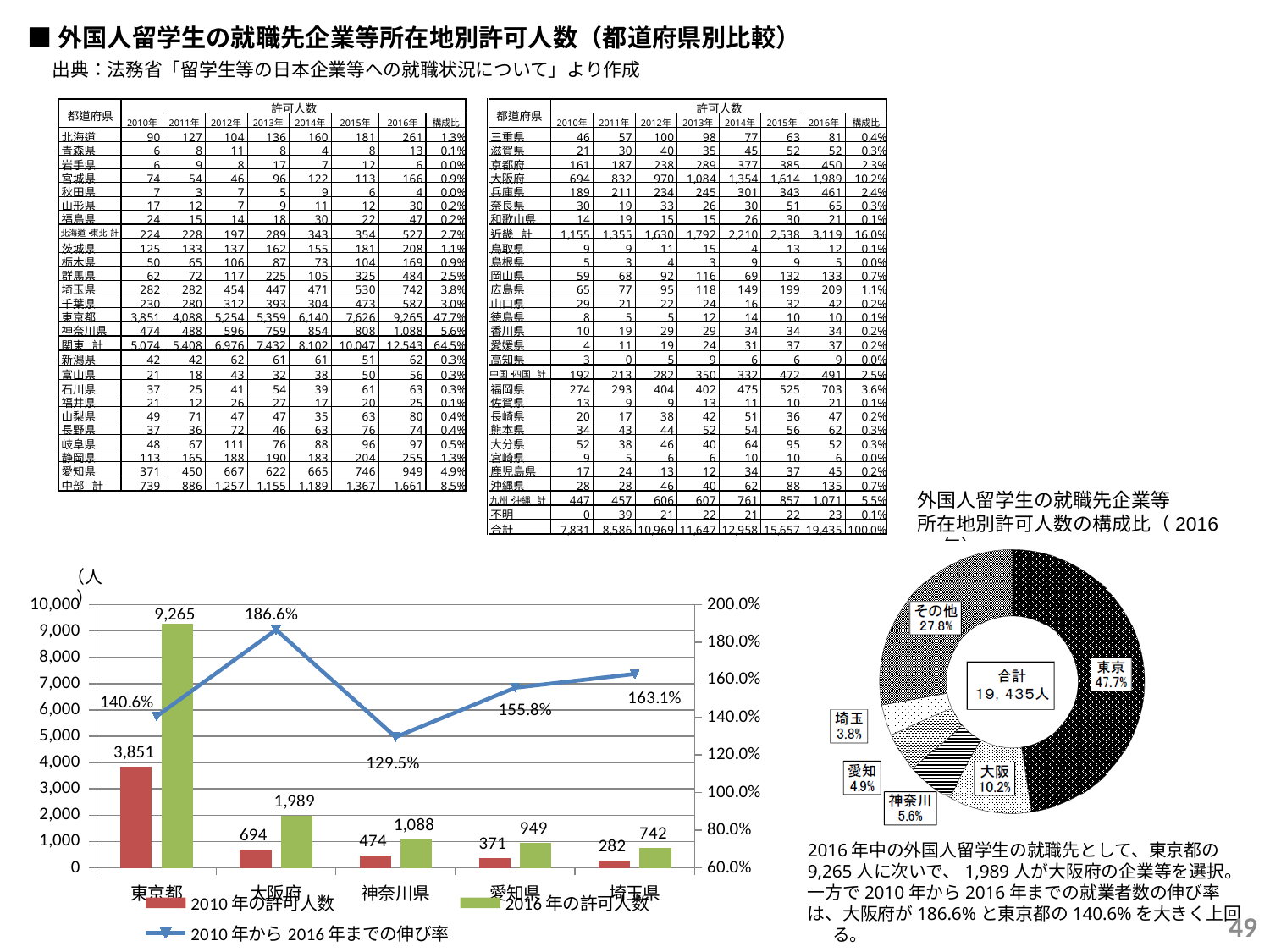
In the bar-and-line chart at the bottom left, what is the 2016 年の許可人数 value for 東京都? 9,265 In the bar-and-line chart at the bottom left, what is the 2010 年から 2016 年までの伸び率 for 神奈川県? 129.5% How many prefectures are shown on the x axis of the bar-and-line chart at the bottom left? 5 In the pie chart at the bottom right, what share does 東京 have? 47.7% In the pie chart at the bottom right, what is the 合計 shown in the centre? 19,435人 In the bar-and-line chart at the bottom left, which prefecture has the highest 2010 年から 2016 年までの伸び率? 大阪府 In the bar-and-line chart at the bottom left, which prefecture has the lowest 2016 年の許可人数? 埼玉県 What kind of chart is shown at the bottom right of the slide? Doughnut (ring) chart In the bar-and-line chart at the bottom left, what is the difference between the 2016 and 2010 許可人数 for 愛知県? 578 In the bar-and-line chart at the bottom left, which is larger: the 2016 年の許可人数 for 神奈川県 or for 愛知県? 神奈川県 In the bar-and-line chart at the bottom left, what is the 2010 年の許可人数 value for 大阪府? 694 How many series does the legend of the bar-and-line chart at the bottom left list? 3